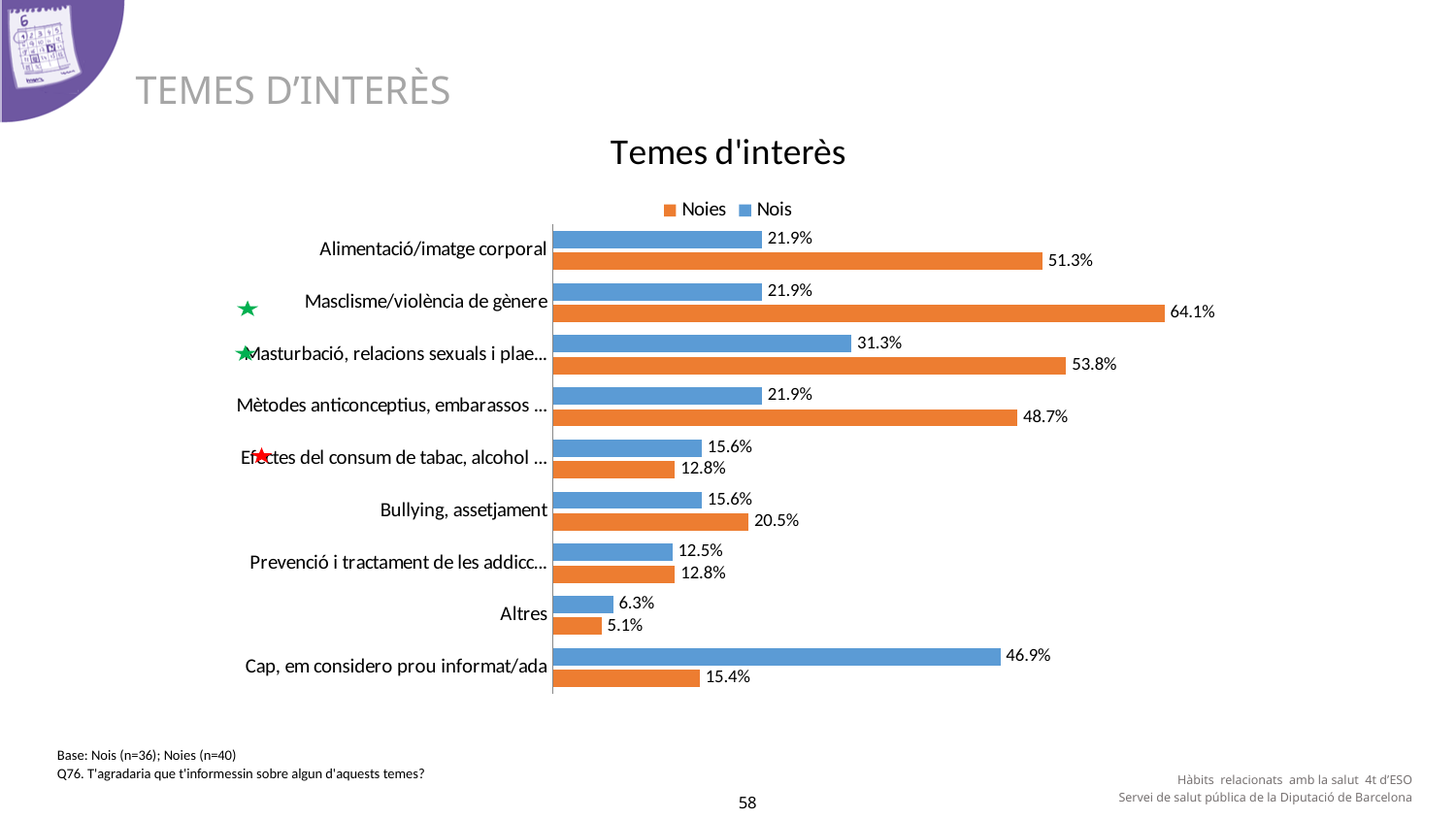
How many categories are shown in the chart? 9 What is the Noies value for Alimentació/imatge corporal? 51.3% Which category has the highest Noies value? Masclisme/violència de gènere What kind of chart is shown on the slide? Bar chart How many series does the legend list? 2 What is the Noies value for Masclisme/violència de gènere? 64.1% What is the Nois value for Cap, em considero prou informat/ada? 46.9% What is the Nois value for Bullying, assetjament? 15.6% For Cap, em considero prou informat/ada, which is larger: the Nois value or the Noies value? Nois Which category has the lowest Nois value? Altres What is the title of the chart? Temes d'interès What is the difference between the Noies and Nois values for Masclisme/violència de gènere? 42.2%